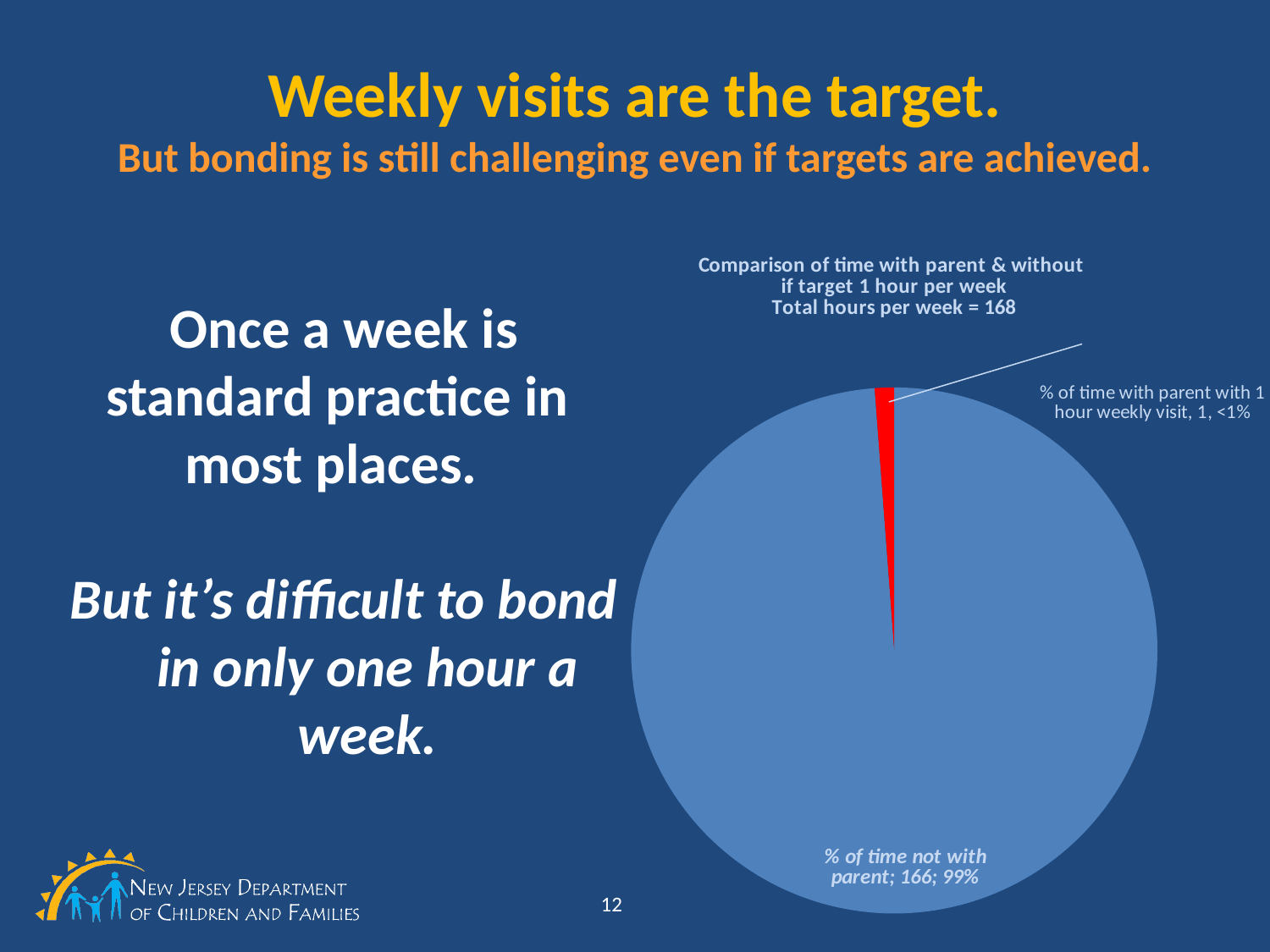
What is the title of the pie chart? Comparison of time with parent & without if target 1 hour per week Total hours per week = 168 Which slice of the pie chart is the largest? % of time not with parent Which slice of the pie chart is the smallest? % of time with parent with 1 hour weekly visit What kind of chart is shown on the slide? pie chart What value is shown for the slice "% of time with parent with 1 hour weekly visit"? 1 What is the difference between the value for "% of time not with parent" and the value for "% of time with parent with 1 hour weekly visit"? 165 What colour is the slice for "% of time with parent with 1 hour weekly visit"? red What percentage share is shown for the slice "% of time not with parent"? 99% Which is larger: the value for "% of time not with parent" or the value for "% of time with parent with 1 hour weekly visit"? % of time not with parent What percentage share is shown for the slice "% of time with parent with 1 hour weekly visit"? <1% How many slices does the pie chart have? 2 What value is shown for the slice "% of time not with parent"? 166